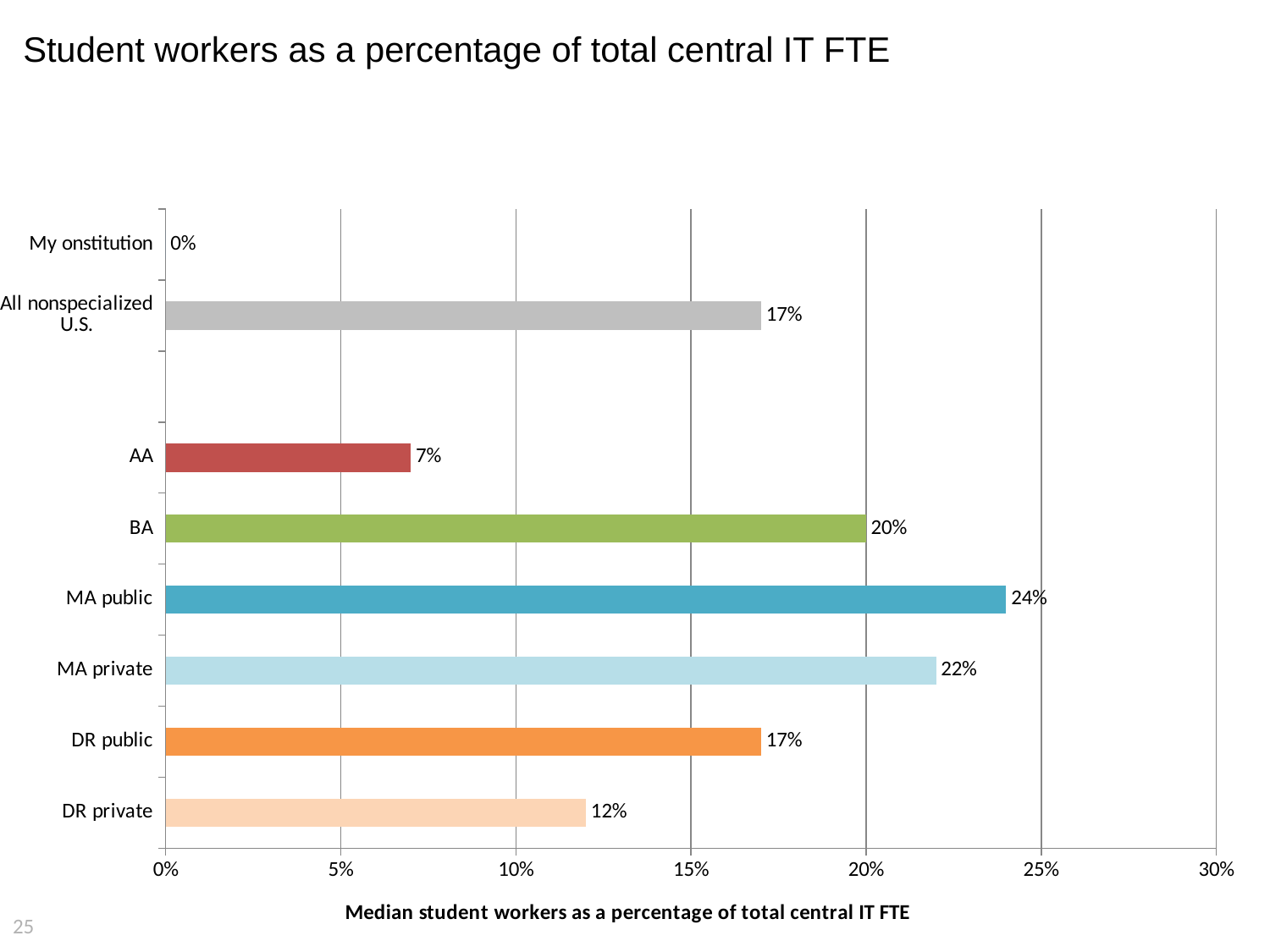
What is the x-axis title of the chart? Median student workers as a percentage of total central IT FTE What is the value for MA public? 24% Which category has the highest value? MA public Which is larger, the value for DR public or the value for DR private? DR public What is the value for DR private? 12% Which category with a plotted bar has the lowest value? AA What is the value for All nonspecialized U.S.? 17% What kind of chart is shown on the slide? bar chart What is the value for AA? 7% What is the difference between the values for BA and AA? 13% What is the difference between the values for MA public and MA private? 2% Is the value for BA greater or less than 15%? greater